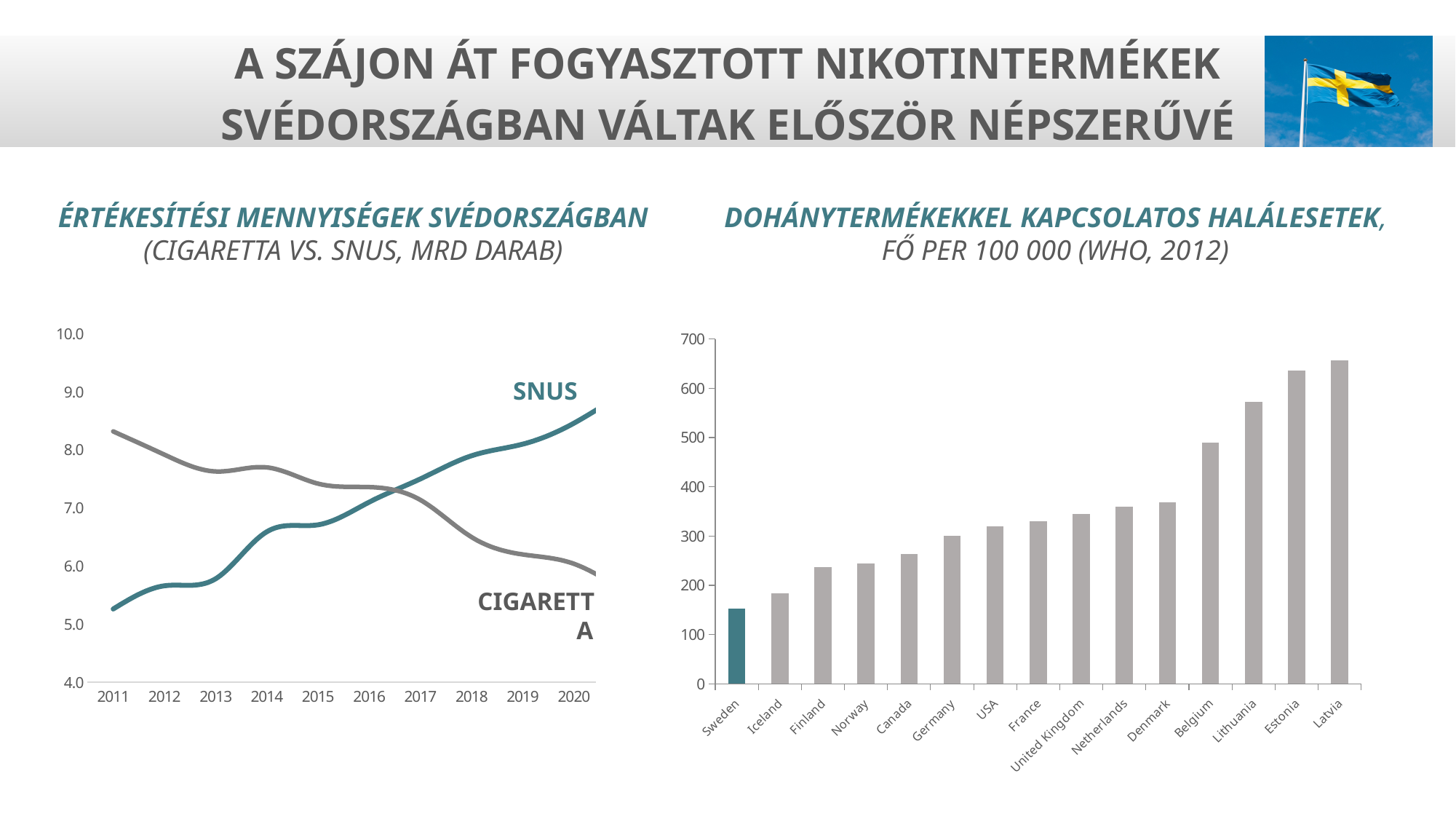
In the chart on the right, is the value for Sweden greater or less than 200? less In the chart on the left, how many series are plotted? 2 What kind of chart is the chart on the left, titled 'Értékesítési mennyiségek Svédországban'? line chart In the chart on the left, does the SNUS line rise or fall from 2011 to 2020? rise In the chart on the right, is the value for Latvia greater or less than 600? greater In the chart on the right, which country has the highest value? Latvia In the chart on the right, which country has the lowest value? Sweden In the chart on the right, which has a larger value, Estonia or Belgium? Estonia How many countries are shown in the chart on the right? 15 In the chart on the left, is the value for CIGARETTA in 2011 greater or less than 8.0? greater What kind of chart is the chart on the right, titled 'Dohánytermékekkel kapcsolatos halálesetek'? bar chart In the chart on the right, which bar is shown in a different colour from the others? Sweden